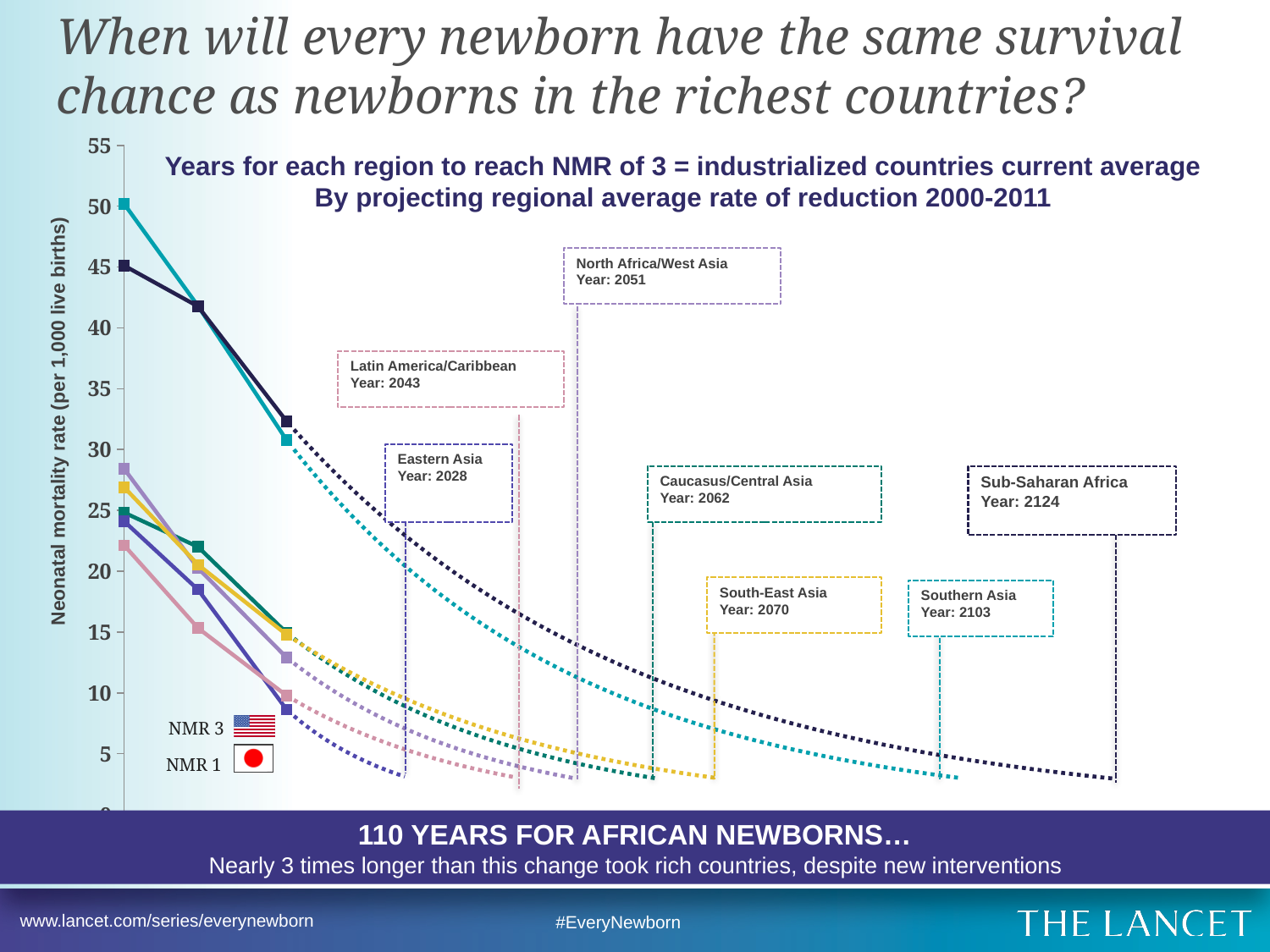
Which region is projected to reach an NMR of 3 later, South-East Asia or Caucasus/Central Asia? South-East Asia How many regions have a projected year labelled on the chart? 7 How many years later is Sub-Saharan Africa projected to reach an NMR of 3 than Eastern Asia? 96 years Which region is projected to reach an NMR of 3 latest? Sub-Saharan Africa Which region is projected to reach an NMR of 3 earliest? Eastern Asia In what year is Eastern Asia projected to reach an NMR of 3? 2028 In what year is Latin America/Caribbean projected to reach an NMR of 3? 2043 In what year is Sub-Saharan Africa projected to reach an NMR of 3? 2124 Do the neonatal mortality rate lines rise or fall along the x axis? Fall What is the label on the y axis of the chart? Neonatal mortality rate (per 1,000 live births) In what year is Southern Asia projected to reach an NMR of 3? 2103 What type of chart is shown on the slide? Line chart